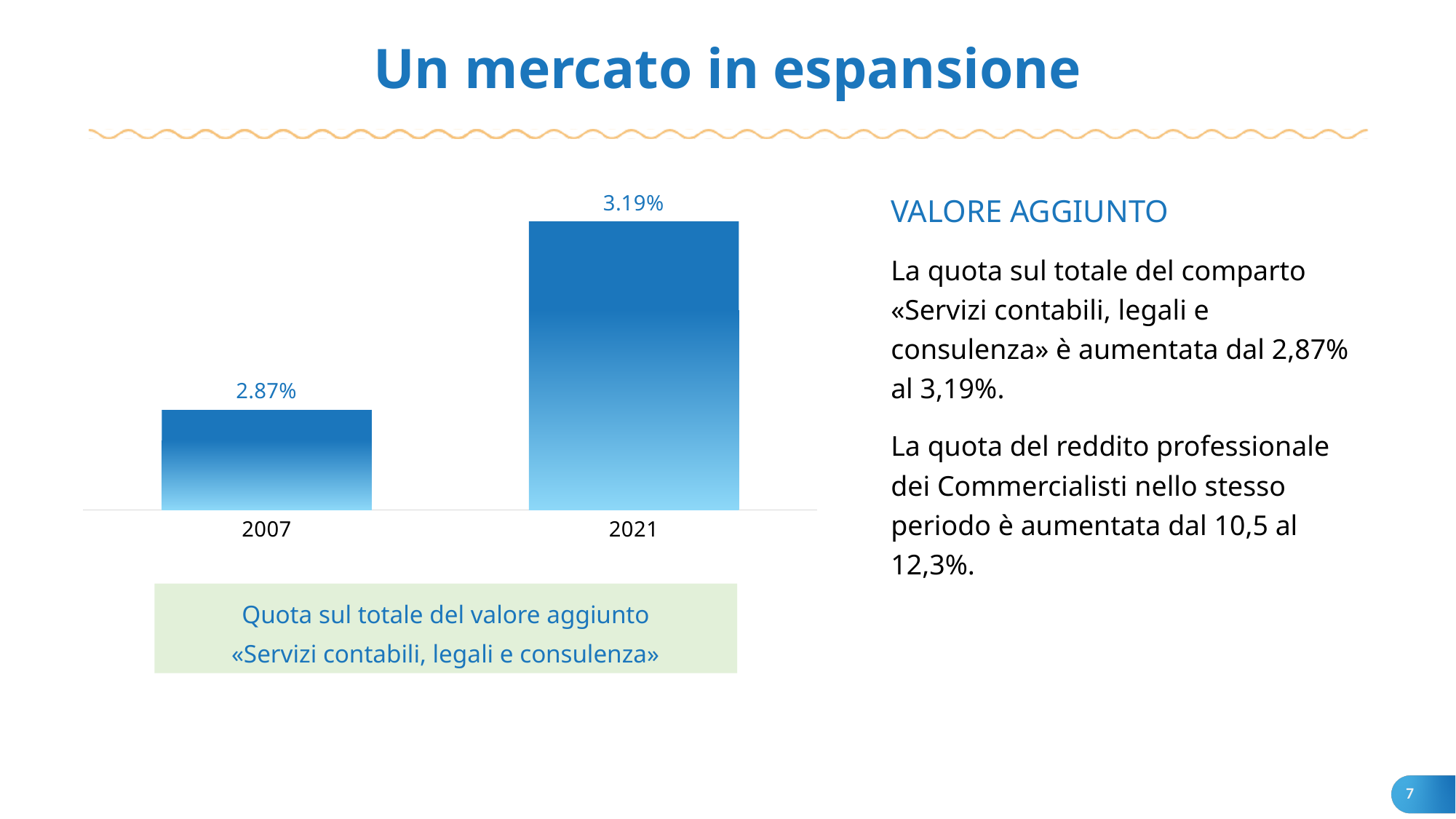
What is the value shown for 2021? 3.19% How many bars are plotted in the chart? 2 What colour are the bars in the chart? blue What is the difference between the 2021 value and the 2007 value? 0.32% What is the caption shown below the chart? Quota sul totale del valore aggiunto «Servizi contabili, legali e consulenza» What kind of chart is shown on the slide? bar chart Do the values rise or fall from 2007 to 2021? rise What is the value shown for 2007? 2.87% Which year has the lower value? 2007 Which year has the higher value? 2021 Is the value for 2021 larger or smaller than the value for 2007? larger